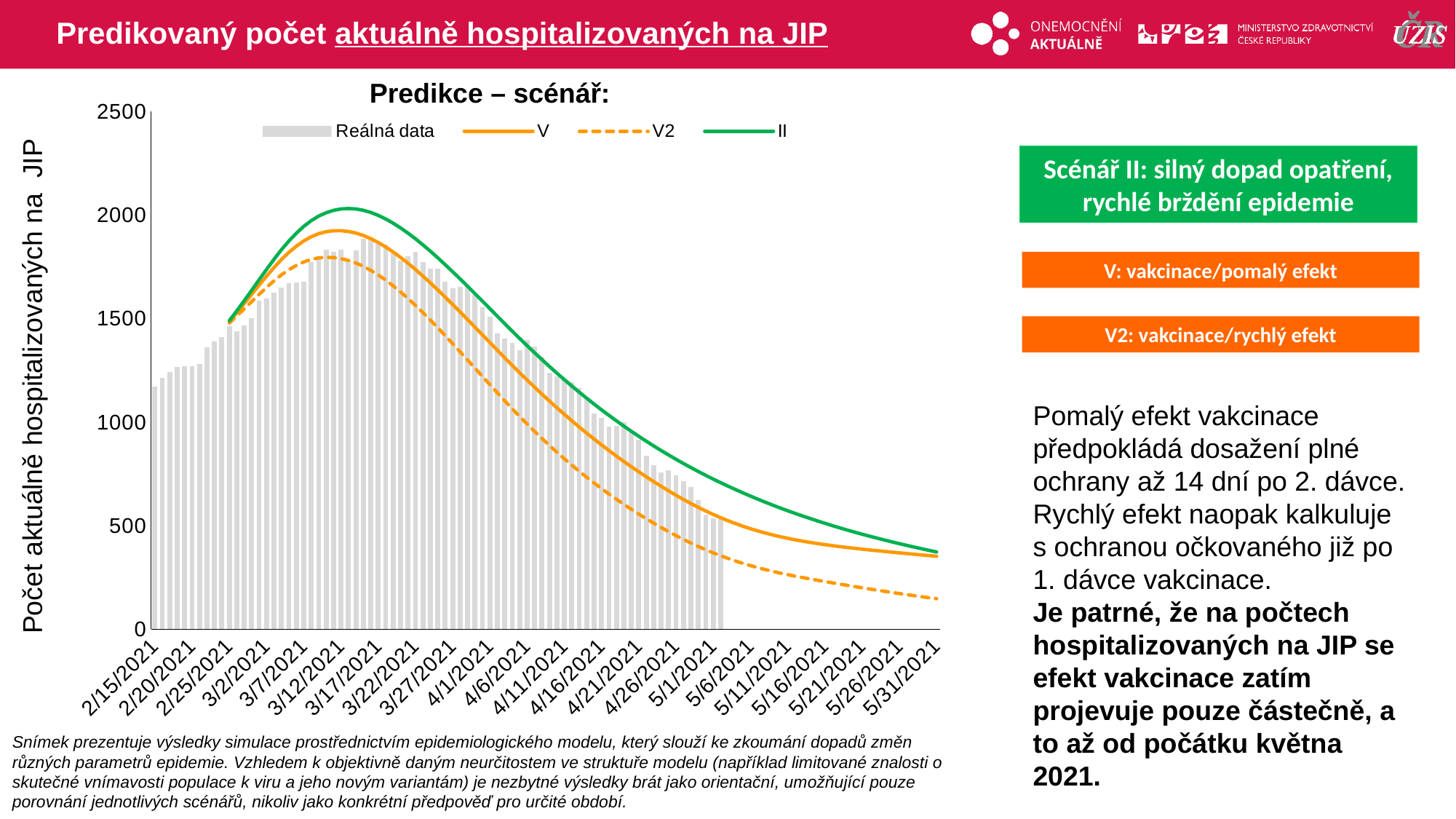
What kind of chart is shown on the slide? Combined bar and line chart Is the peak value of the V line greater or less than 2000? less How many series does the chart legend list? 4 Which scenario line has the lowest value at 5/31/2021? V2 At 5/31/2021, which is larger: the II line or the V2 line? II Is the value of the II line at 5/31/2021 greater or less than 500? less Is the first Reálná data bar at 2/15/2021 greater or less than 1000? greater Do the scenario lines rise or fall between 3/17/2021 and 5/31/2021? fall Which scenario line reaches the highest peak value? II What is the label of the vertical axis of the chart? Počet aktuálně hospitalizovaných na JIP Which series in the legend is drawn as a dashed line? V2